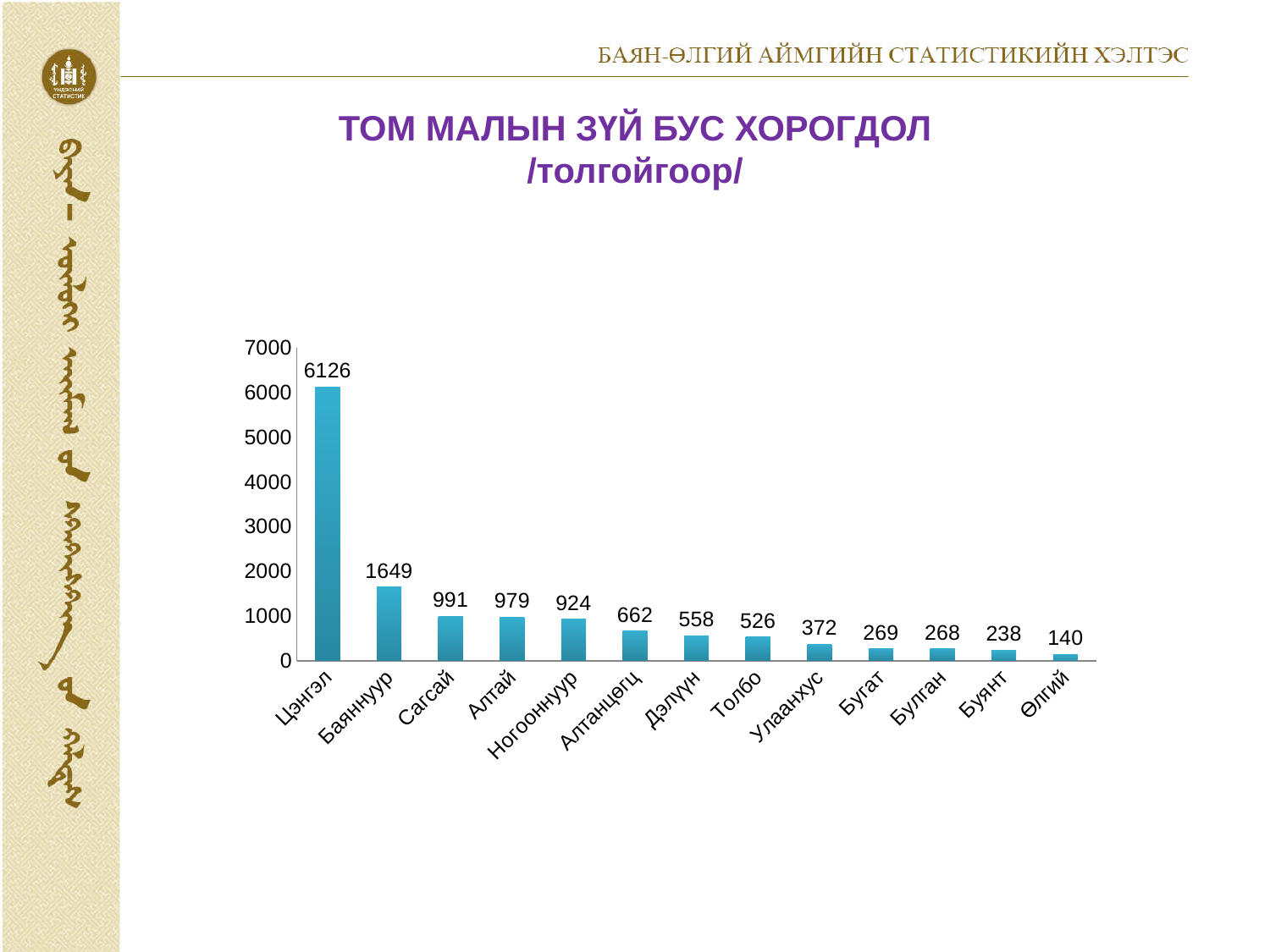
How many categories are shown on the x axis? 13 Do the values rise or fall from left to right along the x axis? fall What kind of chart is shown on the slide? bar chart What is the difference between the values for Цэнгэл and Баяннуур? 4477 What is the value for Толбо? 526 What is the value for Буянт? 238 What is the value for Цэнгэл? 6126 Which category has the highest value? Цэнгэл What is the difference between the values for Сагсай and Алтай? 12 Which category has the lowest value? Өлгий Is the value for Баяннуур greater or less than 1000? greater Which is larger, the value for Ногооннуур or the value for Алтанцөгц? Ногооннуур